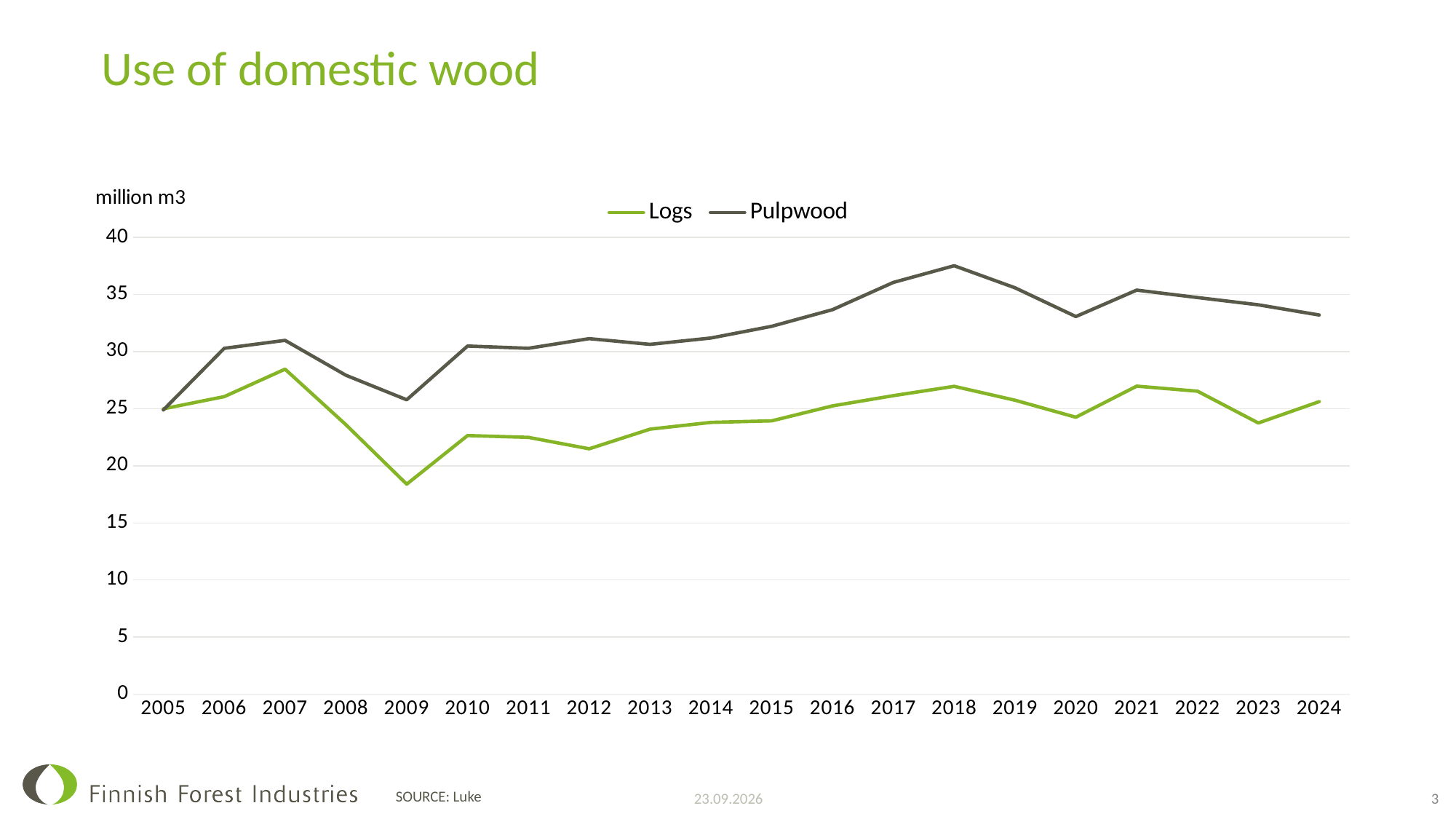
Is the Pulpwood value for 2018 greater or less than 35? greater How many years are shown on the x axis? 20 In which year is the Logs value highest? 2007 What kind of chart is shown on the slide? line chart How many series does the legend list? 2 In which year is the Pulpwood value highest? 2018 In which year is the Logs value lowest? 2009 In 2024, which series has the larger value, Logs or Pulpwood? Pulpwood Is the Pulpwood value for 2020 greater or less than 35? less Does the Pulpwood value rise or fall from 2018 to 2020? fall Is the Logs value for 2009 greater or less than 20? less What unit is shown above the y axis? million m3